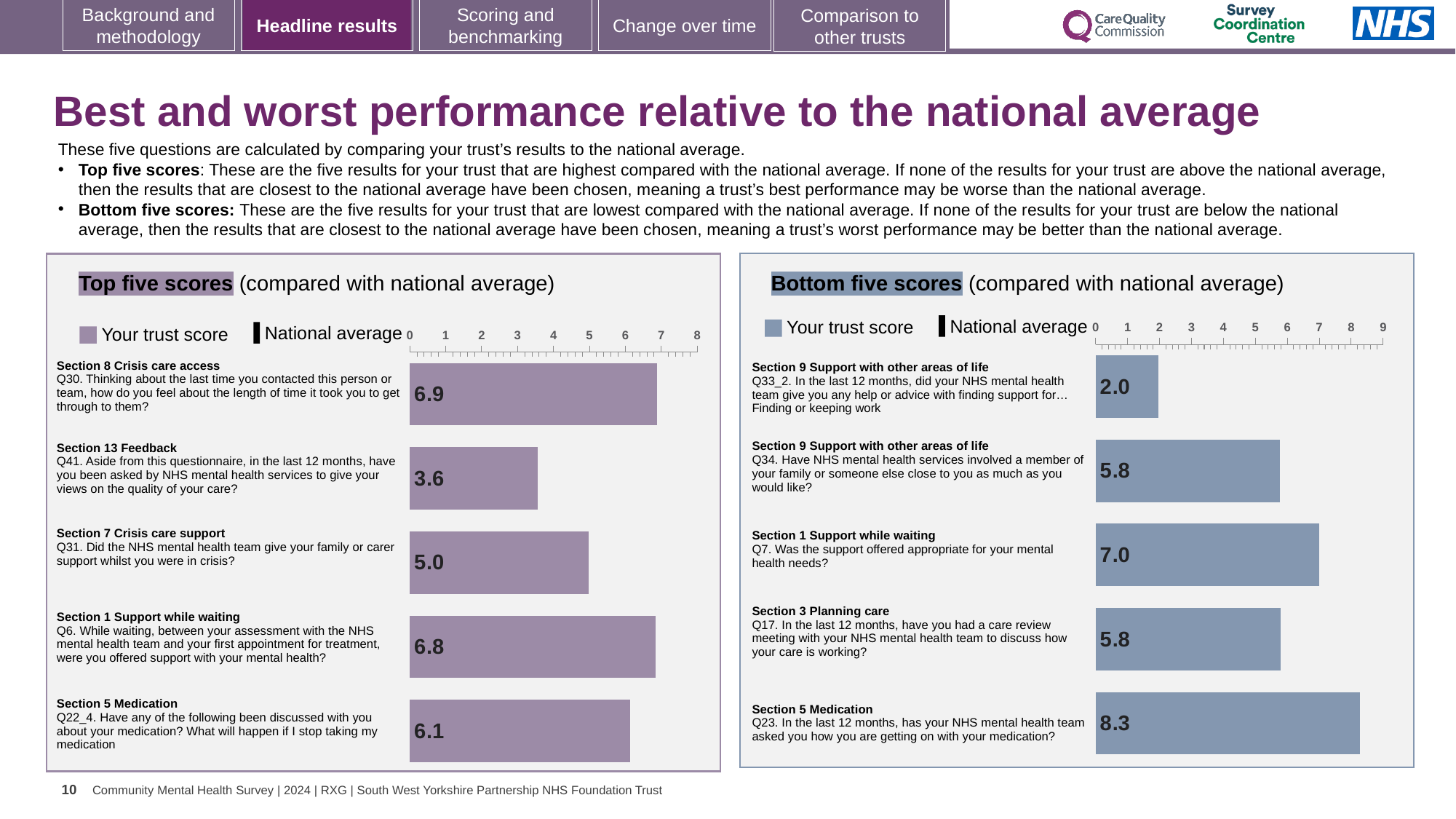
In the Bottom five scores chart, what is the trust score for Q23 (Section 5 Medication)? 8.3 In the Bottom five scores chart, which question has the highest trust score? Q23 In the Bottom five scores chart, what is the difference between the trust scores for Q7 and Q34? 1.2 In the Top five scores chart, what is the trust score for Q41 (Section 13 Feedback)? 3.6 How many questions are plotted in the Bottom five scores chart? 5 In the Top five scores chart, what is the trust score for Q30 (Section 8 Crisis care access)? 6.9 How many entries does the legend of the Top five scores chart list? 2 In the Bottom five scores chart, what is the trust score for Q33_2 (Section 9 Support with other areas of life)? 2.0 In the Top five scores chart, which question has the lowest trust score? Q41 What type of chart is the Top five scores chart? Bar chart In the Top five scores chart, which has the larger trust score, Q31 or Q6? Q6 In the Top five scores chart, what is the difference between the trust scores for Q30 and Q22_4? 0.8